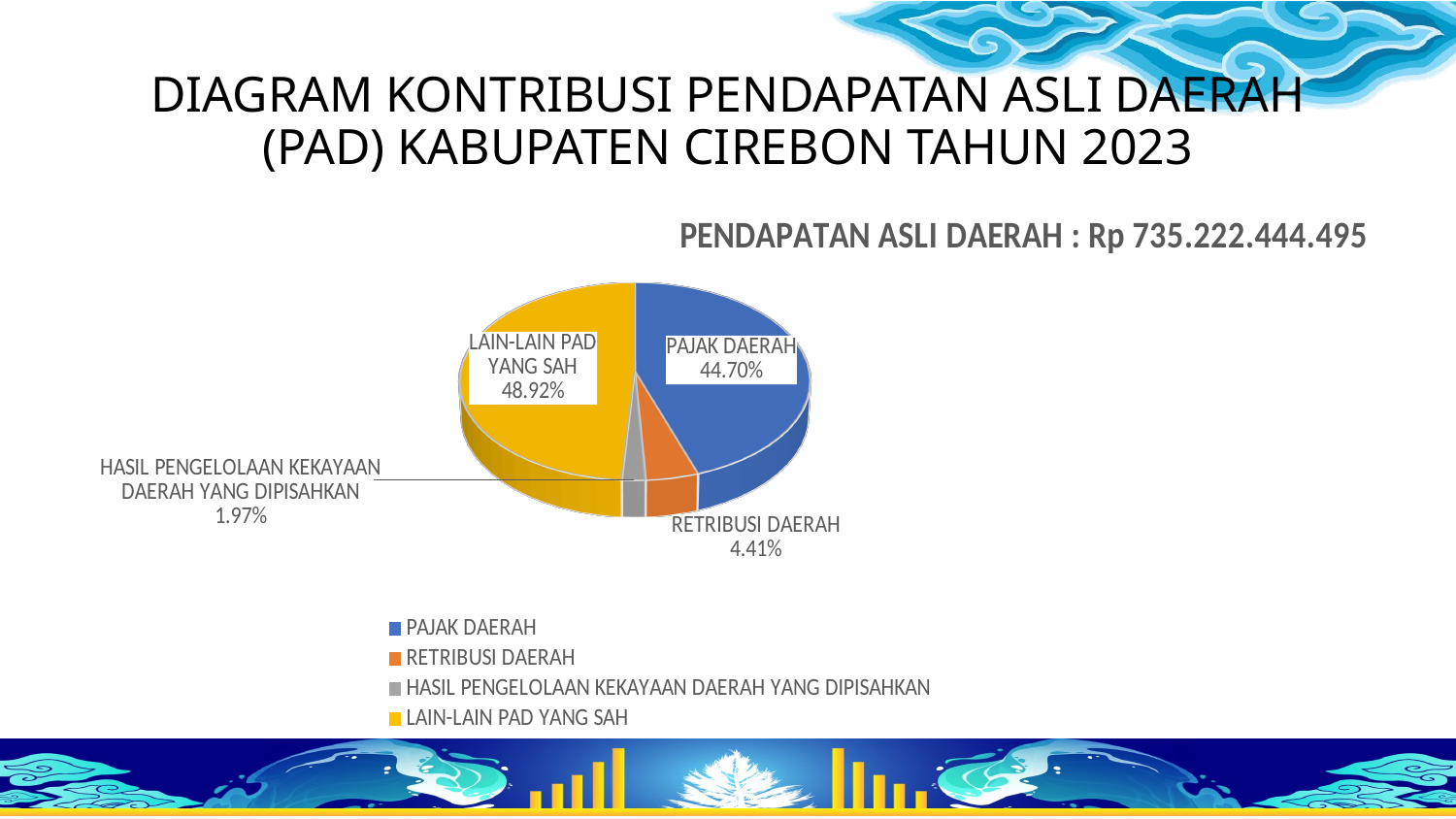
What type of chart is shown on the slide? Pie chart What total PENDAPATAN ASLI DAERAH value is stated above the chart? Rp 735.222.444.495 How many categories are shown in the pie chart? 4 Which category has the largest share of the pie? LAIN-LAIN PAD YANG SAH Which category has the smallest share of the pie? HASIL PENGELOLAAN KEKAYAAN DAERAH YANG DIPISAHKAN What share of the pie does HASIL PENGELOLAAN KEKAYAAN DAERAH YANG DIPISAHKAN represent? 1.97% How many entries does the legend list? 4 Which is larger, the share for RETRIBUSI DAERAH or the share for HASIL PENGELOLAAN KEKAYAAN DAERAH YANG DIPISAHKAN? RETRIBUSI DAERAH What is the difference in percentage points between LAIN-LAIN PAD YANG SAH and PAJAK DAERAH? 4.22% What share of the pie does PAJAK DAERAH represent? 44.70% What share of the pie does RETRIBUSI DAERAH represent? 4.41% What share of the pie does LAIN-LAIN PAD YANG SAH represent? 48.92%